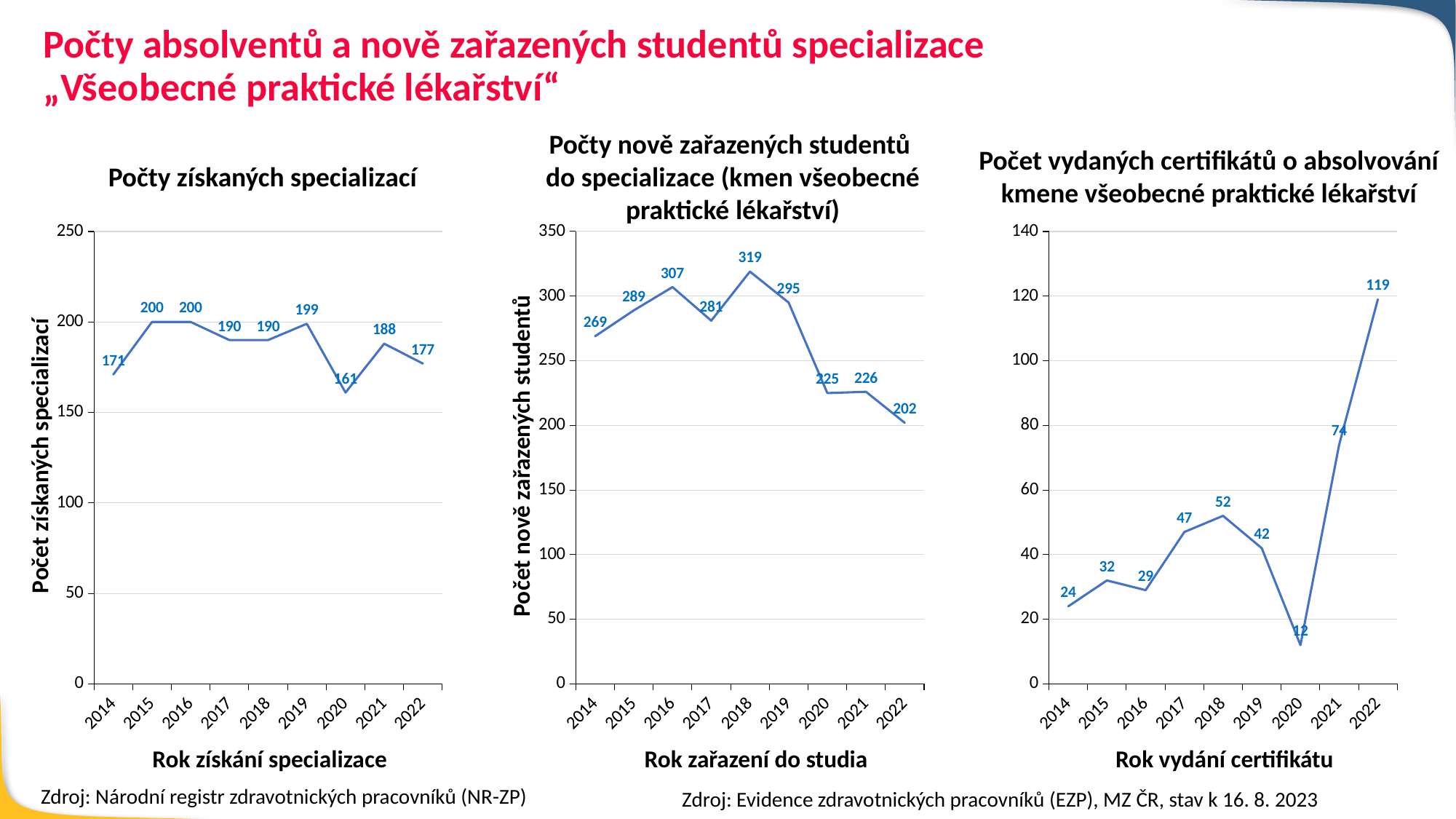
In the right chart ("Počet vydaných certifikátů o absolvování kmene"), what is the value for 2021? 74 In the right chart ("Počet vydaných certifikátů o absolvování kmene"), what is the difference between the values for 2022 and 2021? 45 In the middle chart ("Počty nově zařazených studentů do specializace"), which year has the highest value? 2018 In the right chart ("Počet vydaných certifikátů o absolvování kmene"), which year has the lowest value? 2020 How many years are plotted on the x axis of the chart "Počty získaných specializací"? 9 What type of chart is the right chart ("Počet vydaných certifikátů o absolvování kmene")? line chart In the chart "Počty získaných specializací", which year has the lowest value? 2020 In the middle chart ("Počty nově zařazených studentů do specializace"), do the values generally rise or fall from 2019 to 2022? fall In the chart "Počty získaných specializací", what is the value for 2020? 161 In the middle chart ("Počty nově zařazených studentů do specializace"), which is larger, the value for 2014 or the value for 2022? 2014 In the middle chart ("Počty nově zařazených studentů do specializace"), what is the value for 2018? 319 In the chart "Počty získaných specializací", what is the difference between the values for 2019 and 2022? 22